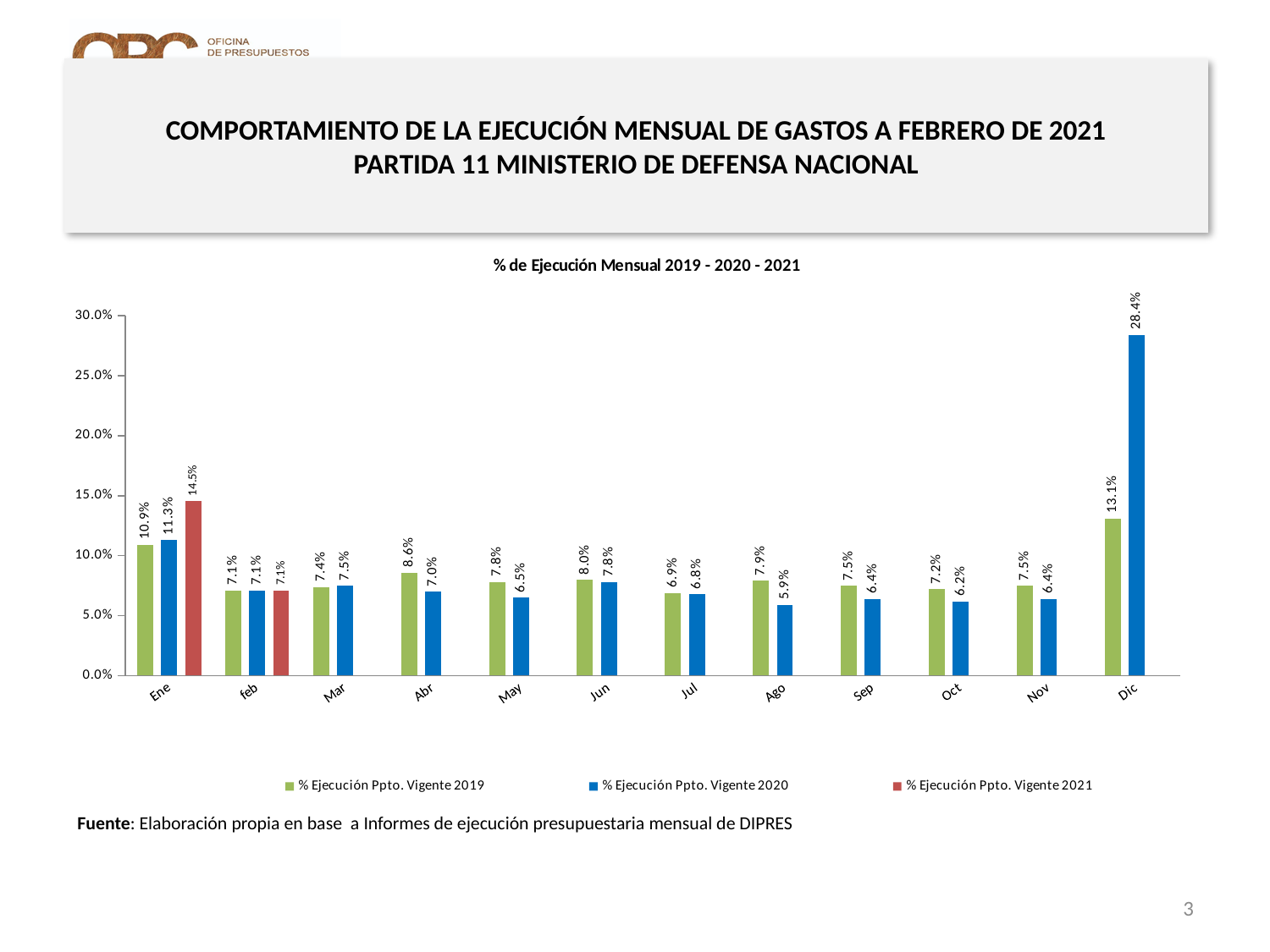
What is the value for Ago in the % Ejecución Ppto. Vigente 2020 series? 5.9% Which is larger for Abr: the 2019 value or the 2020 value? 2019 Which month has the highest value in the % Ejecución Ppto. Vigente 2020 series? Dic Which month has the lowest value in the % Ejecución Ppto. Vigente 2020 series? Ago What kind of chart is shown on the slide? Bar chart Is the value for Dic in the 2020 series greater or less than 25.0%? greater What is the value for Abr in the % Ejecución Ppto. Vigente 2019 series? 8.6% What is the difference between the 2020 and 2019 values for Dic? 15.3% What is the value for Dic in the % Ejecución Ppto. Vigente 2020 series? 28.4% What is the title of the chart? % de Ejecución Mensual 2019 - 2020 - 2021 How many series does the legend list? 3 What is the value for Ene in the % Ejecución Ppto. Vigente 2021 series? 14.5%